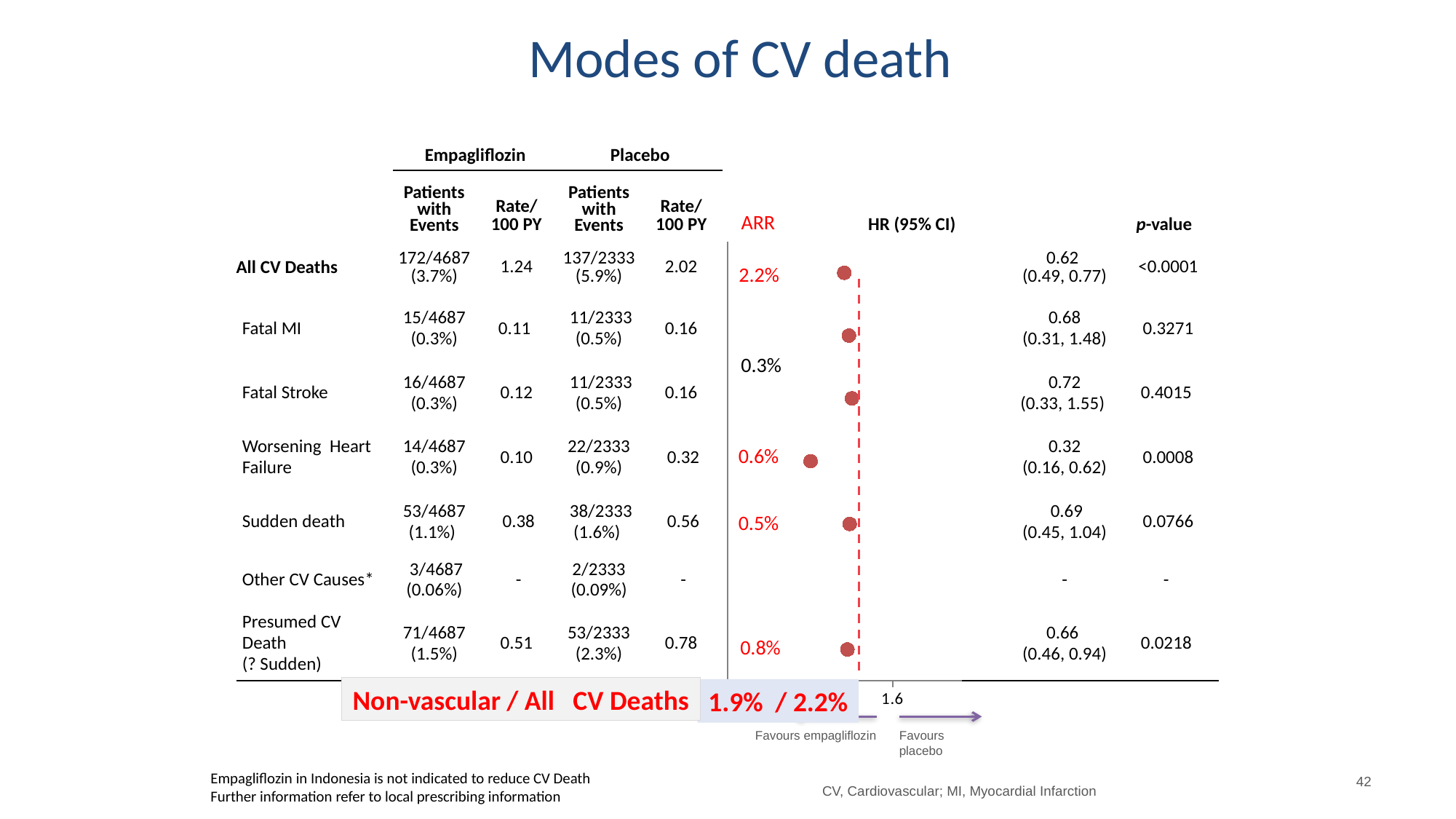
Which mode of CV death has the lowest hazard ratio? Worsening Heart Failure How many hazard ratio points are plotted on the forest plot? 6 What is the hazard ratio (HR) for Worsening Heart Failure? 0.32 Is the hazard ratio for Fatal Stroke greater or less than 1.6? less Which plotted mode of CV death has the highest hazard ratio? Fatal Stroke Which has the larger hazard ratio, Fatal MI or Fatal Stroke? Fatal Stroke What kind of chart is shown on the slide? forest plot Which treatment does the right side of the hazard ratio axis favour? placebo What is the difference between the placebo and empagliflozin rates per 100 PY for All CV Deaths? 0.78 What is the hazard ratio (HR) for All CV Deaths? 0.62 What is the p-value for Fatal MI? 0.3271 What is the ARR for Sudden death? 0.5%